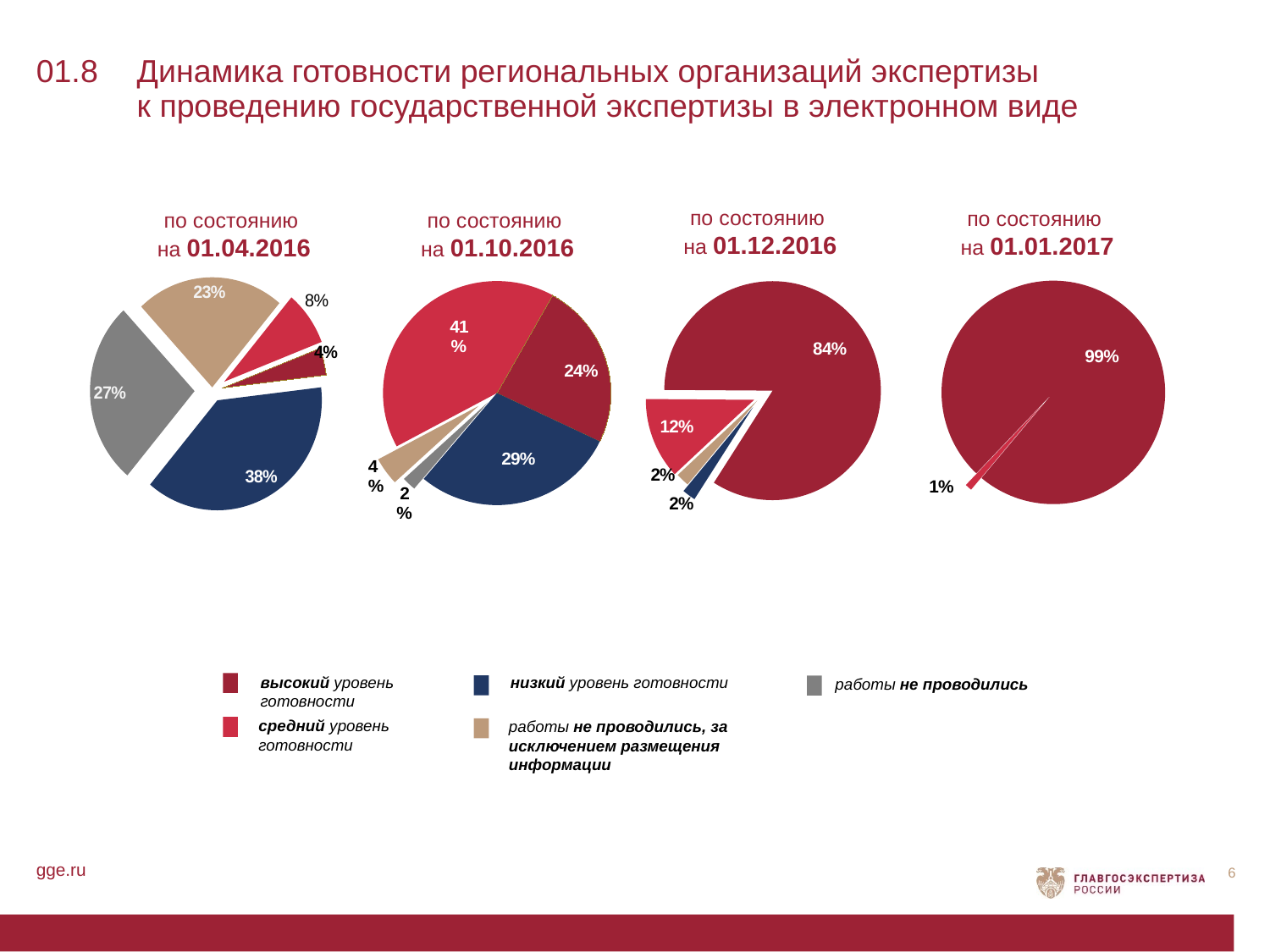
How many slices does the pie chart for 01.04.2016 have? 5 In the pie chart for 01.04.2016, which category has the smallest share? высокий уровень готовности (4%) What type of charts are shown on the slide? Pie charts In the pie chart for 01.10.2016, what share is shown for the низкий уровень готовности slice? 29% In the pie chart for 01.12.2016, what share is shown for the средний уровень готовности slice? 12% In the pie chart for 01.04.2016, what share is labelled for the largest slice (низкий уровень готовности)? 38% How does the share of высокий уровень готовности change across the four dates from 01.04.2016 to 01.01.2017? It rises (4%, 24%, 84%, 99%) In the pie chart for 01.12.2016, what is the difference between the высокий (84%) and средний (12%) slices? 72 percentage points In the pie chart for 01.04.2016, which is larger: the gray slice (работы не проводились) or the tan slice (работы не проводились, за исключением размещения информации)? работы не проводились (27%) How many categories does the legend list? 5 In the pie chart for 01.10.2016, which category has the largest share? средний уровень готовности (41%) In the pie chart for 01.01.2017, what share does the высокий уровень готовности slice have? 99%